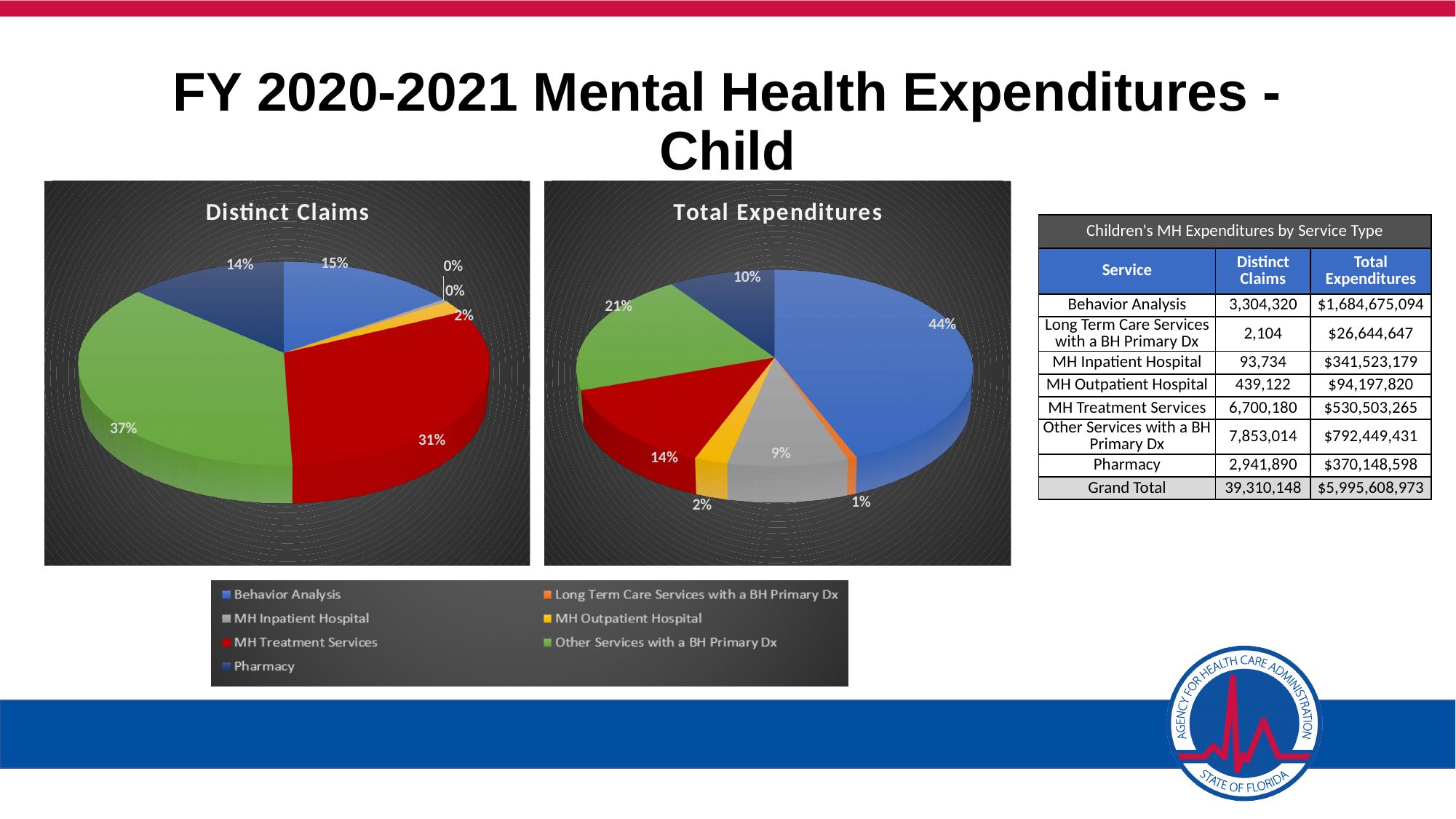
In the Total Expenditures pie chart, what share does MH Inpatient Hospital have? 9% In the Total Expenditures pie chart, which is larger: the share for MH Treatment Services or the share for Pharmacy? MH Treatment Services In the Total Expenditures pie chart, which service has the smallest slice? Long Term Care Services with a BH Primary Dx In the Total Expenditures pie chart, what share does Behavior Analysis have? 44% How many services does the shared legend below the pie charts list? 7 In the Distinct Claims pie chart, what share does Pharmacy have? 14% In the Total Expenditures pie chart, which service has the largest slice? Behavior Analysis What type of chart is the Total Expenditures chart? Pie chart In the Distinct Claims pie chart, which service has the largest slice? Other Services with a BH Primary Dx